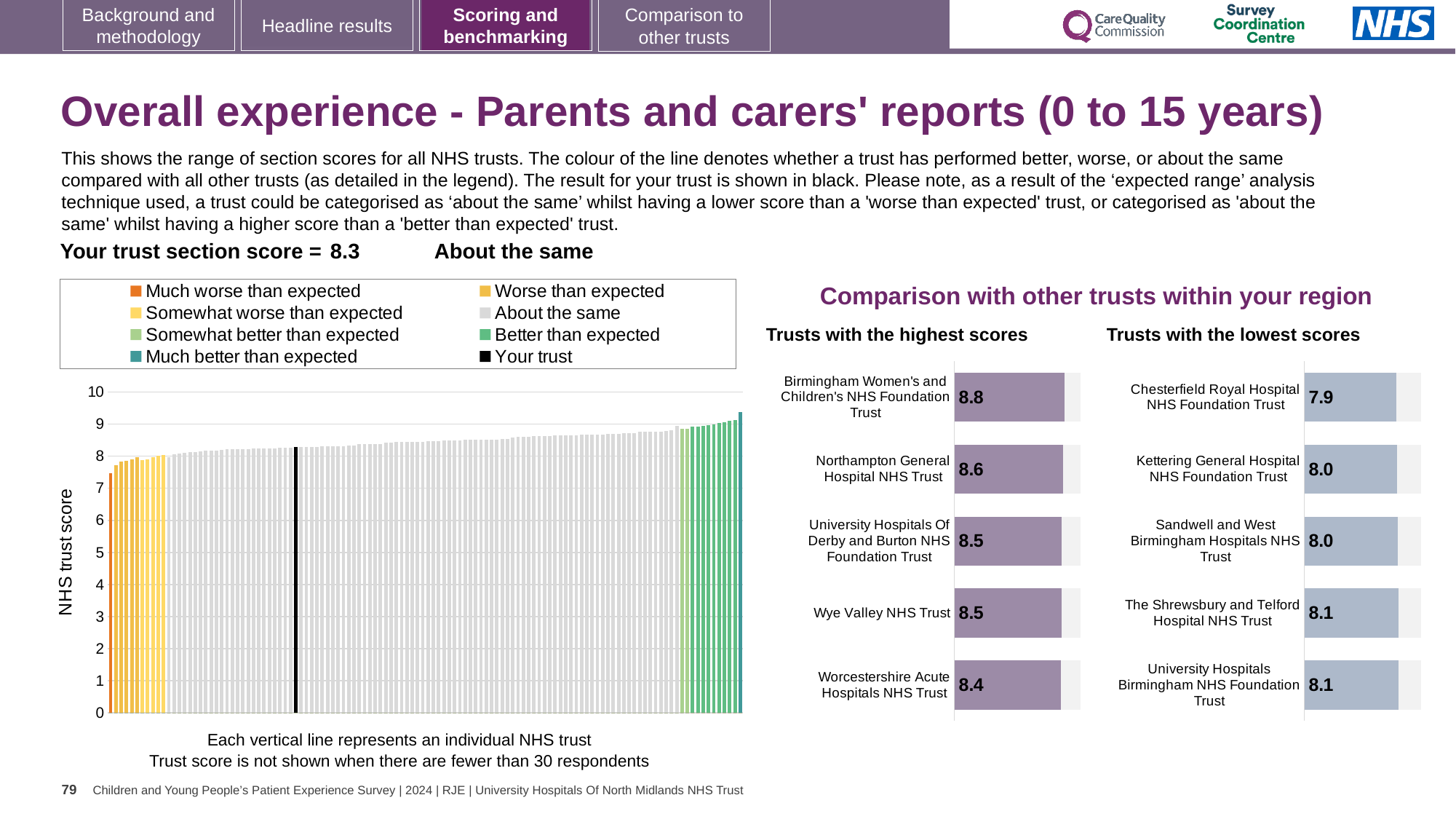
In the 'Trusts with the lowest scores' chart, what is the score for Chesterfield Royal Hospital NHS Foundation Trust? 7.9 In the 'Trusts with the highest scores' chart, what is the score for Birmingham Women's and Children's NHS Foundation Trust? 8.8 In the 'Trusts with the highest scores' chart, which has the higher score: Northampton General Hospital NHS Trust or Wye Valley NHS Trust? Northampton General Hospital NHS Trust In the 'Trusts with the highest scores' chart, which trust has the highest score? Birmingham Women's and Children's NHS Foundation Trust In the 'NHS trust score' chart on the left, is the value of the leftmost (orange) bar greater or less than 8? less How many trusts are listed in the 'Trusts with the highest scores' chart? 5 In the 'NHS trust score' chart on the left, do the bar heights rise or fall from left to right? rise How many entries does the legend above the 'NHS trust score' chart list? 8 In the 'Trusts with the lowest scores' chart, which trust has the lowest score? Chesterfield Royal Hospital NHS Foundation Trust What kind of chart is the 'NHS trust score' chart on the left of the slide? bar chart In the 'Trusts with the lowest scores' chart, what is the score for The Shrewsbury and Telford Hospital NHS Trust? 8.1 In the 'Trusts with the highest scores' chart, what is the difference between the scores of Birmingham Women's and Children's NHS Foundation Trust and Worcestershire Acute Hospitals NHS Trust? 0.4